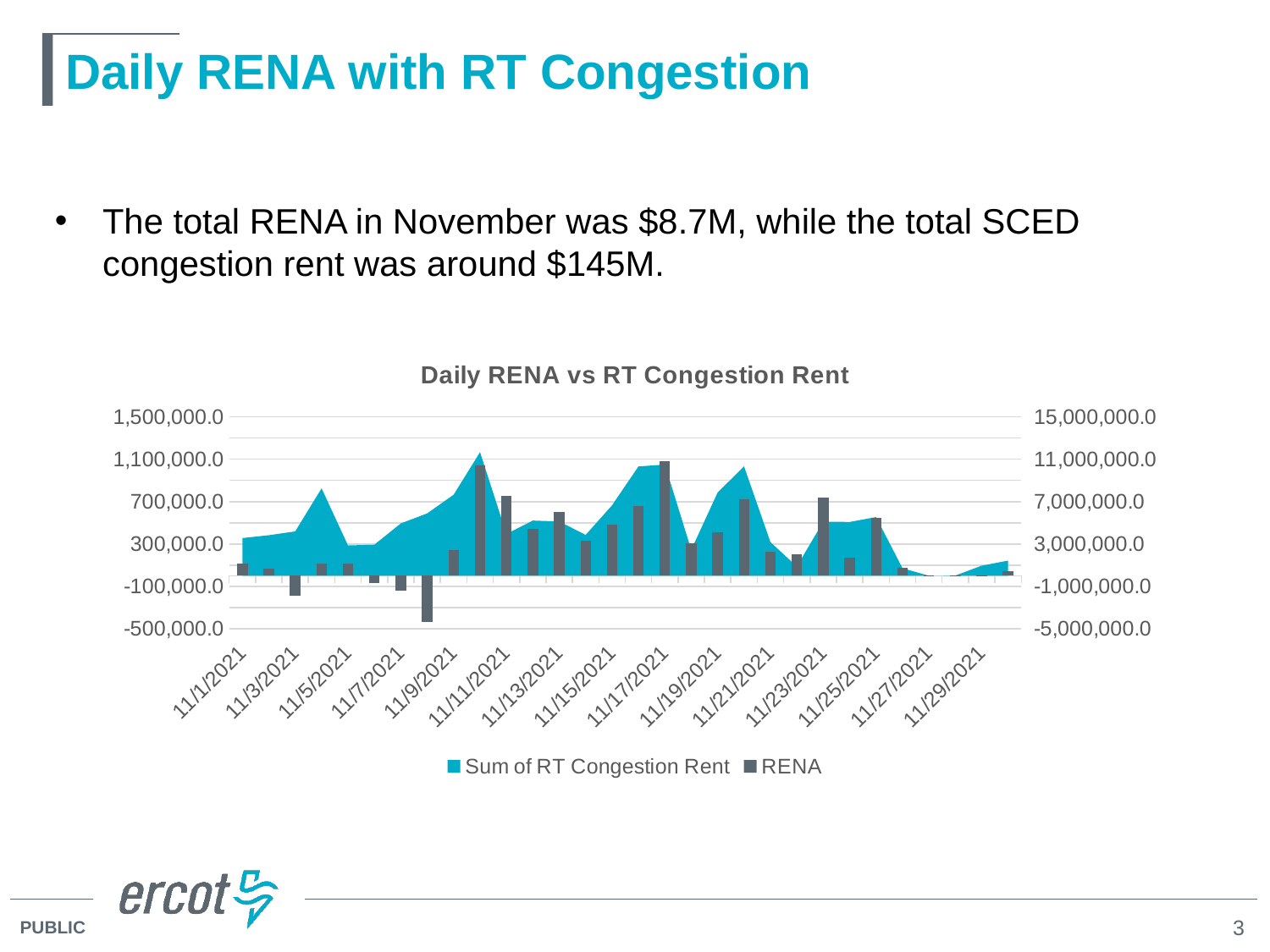
What is the highest value shown on the right y axis? 15,000,000.0 Which series is drawn as the teal shaded area? Sum of RT Congestion Rent What is the title of the chart? Daily RENA vs RT Congestion Rent What is the lowest value shown on the right y axis? -5,000,000.0 Which has the larger RENA bar, 11/9/2021 or 11/11/2021? 11/11/2021 What type of chart is shown on the slide? Combined area and bar chart How many date labels are shown on the x axis of the chart? 15 Does the Sum of RT Congestion Rent area rise or fall from 11/25/2021 to 11/27/2021? fall What is the highest value shown on the left y axis? 1,500,000.0 How many series does the legend of the chart list? 2 Which has the larger RENA bar, 11/1/2021 or 11/17/2021? 11/17/2021 On which date is the RENA bar the lowest (most negative)? 11/8/2021